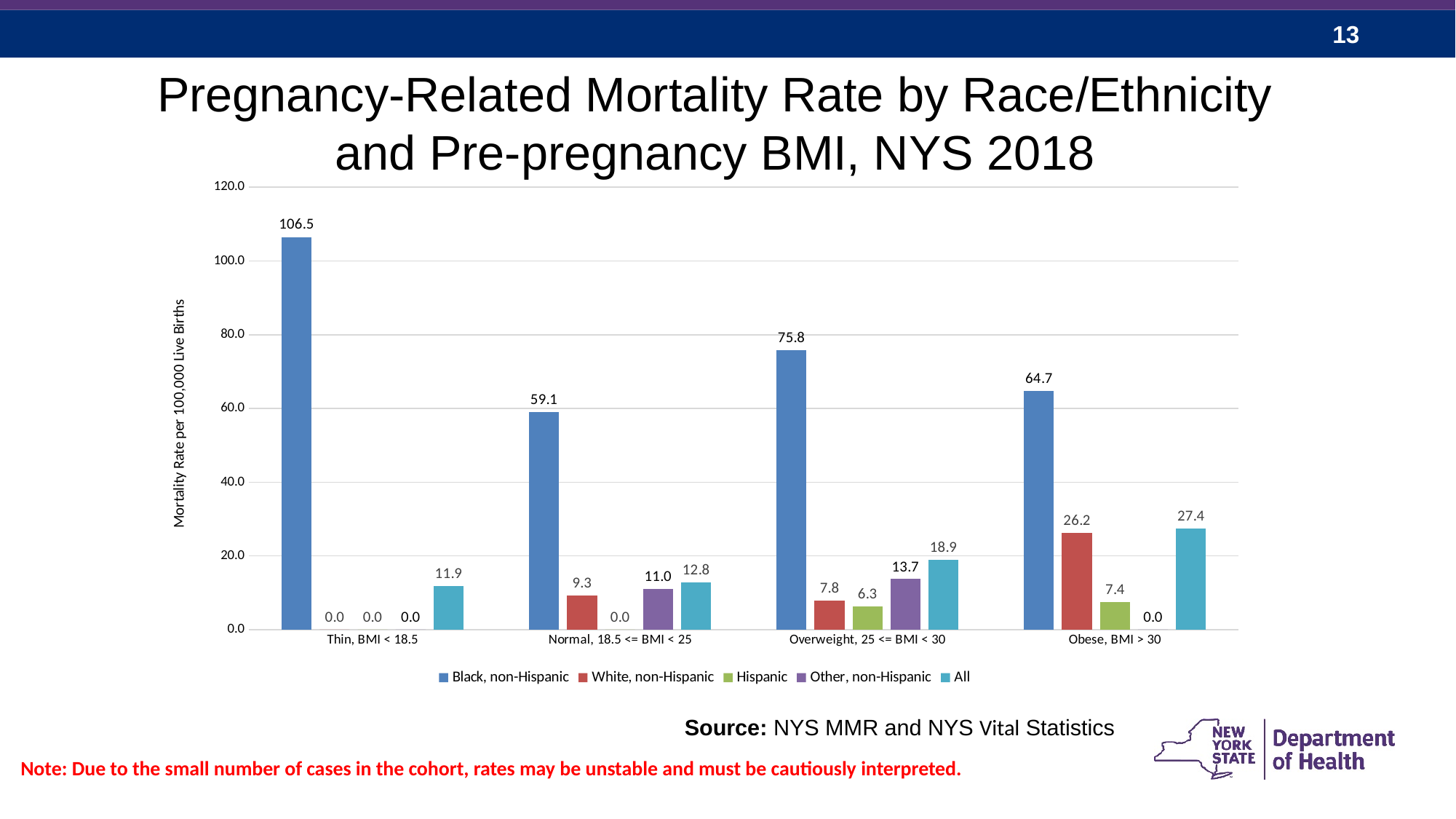
What is the mortality rate for White, non-Hispanic women in the Overweight, 25 <= BMI < 30 category? 7.8 How many BMI categories are shown on the x axis? 4 Which BMI category has the highest mortality rate for Black, non-Hispanic women? Thin, BMI < 18.5 What is the mortality rate for Hispanic women in the Normal, 18.5 <= BMI < 25 category? 0.0 What is the mortality rate for Black, non-Hispanic women in the Thin, BMI < 18.5 category? 106.5 Is the Black, non-Hispanic rate in the Overweight, 25 <= BMI < 30 category greater or less than 60.0? greater What type of chart is shown on the slide? Bar chart How many series does the legend list? 5 Which is larger: the Other, non-Hispanic rate in the Overweight category or the Other, non-Hispanic rate in the Normal category? Overweight, 25 <= BMI < 30 What is the difference between the Black, non-Hispanic rate and the All rate in the Obese, BMI > 30 category? 37.3 Which BMI category has the lowest mortality rate for All women? Thin, BMI < 18.5 What is the mortality rate for All women in the Obese, BMI > 30 category? 27.4